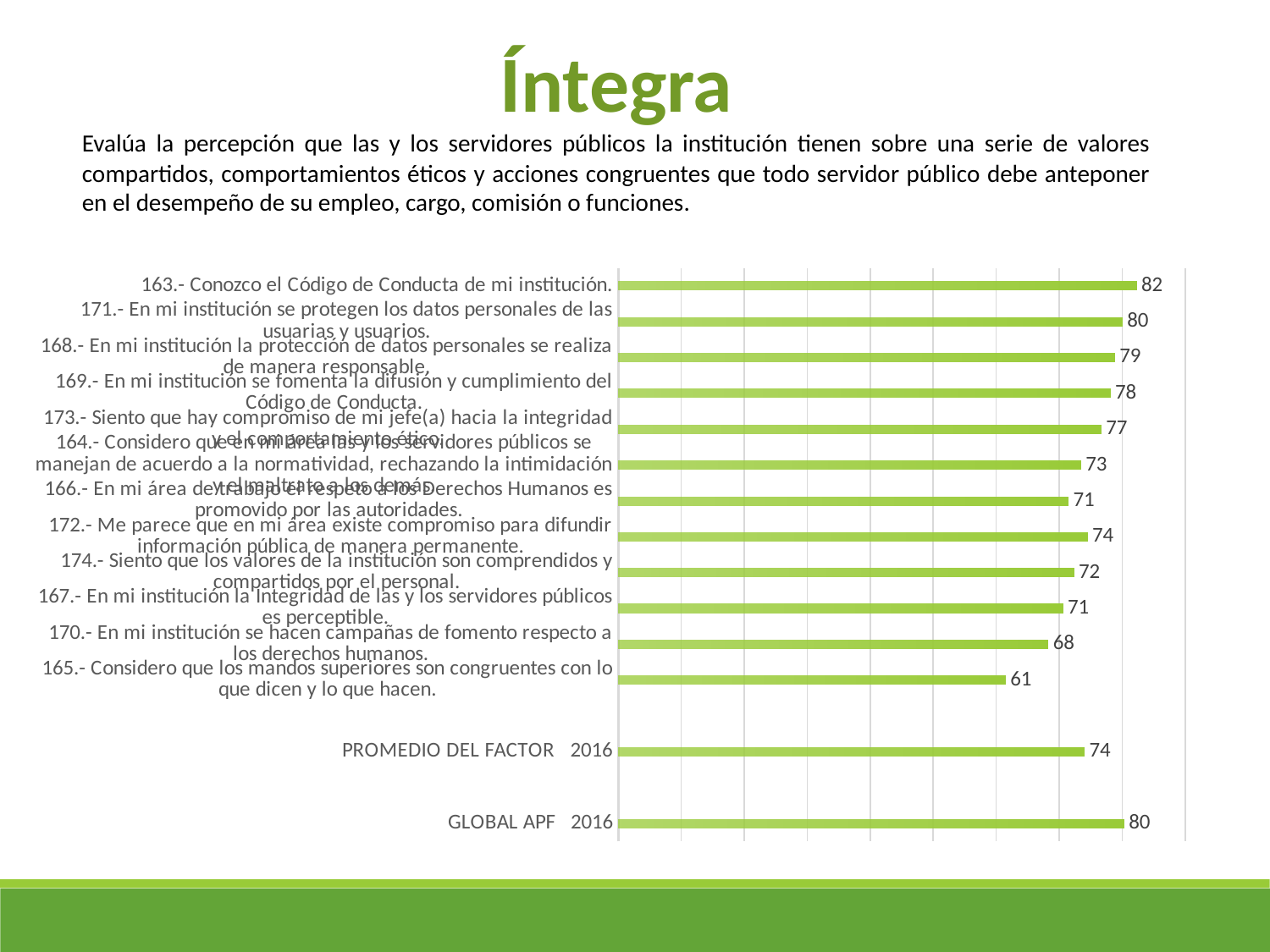
Which item has the lowest value in the chart? 165.- Considero que los mandos superiores son congruentes con lo que dicen y lo que hacen. Which item has the highest value in the chart? 163.- Conozco el Código de Conducta de mi institución. What value is shown for item 163 (Conozco el Código de Conducta de mi institución)? 82 What is the difference between GLOBAL APF 2016 and PROMEDIO DEL FACTOR 2016? 6 Which is larger, the value for item 171 or the value for item 164? Item 171 What value is shown for item 170 (En mi institución se hacen campañas de fomento respecto a los derechos humanos)? 68 What is the difference between the value for item 163 and the value for item 165? 21 How many bars are plotted in the chart? 14 What value is shown for item 165 (Considero que los mandos superiores son congruentes con lo que dicen y lo que hacen)? 61 What value is shown for PROMEDIO DEL FACTOR 2016? 74 What value is shown for GLOBAL APF 2016? 80 What type of chart is shown on the slide? Bar chart